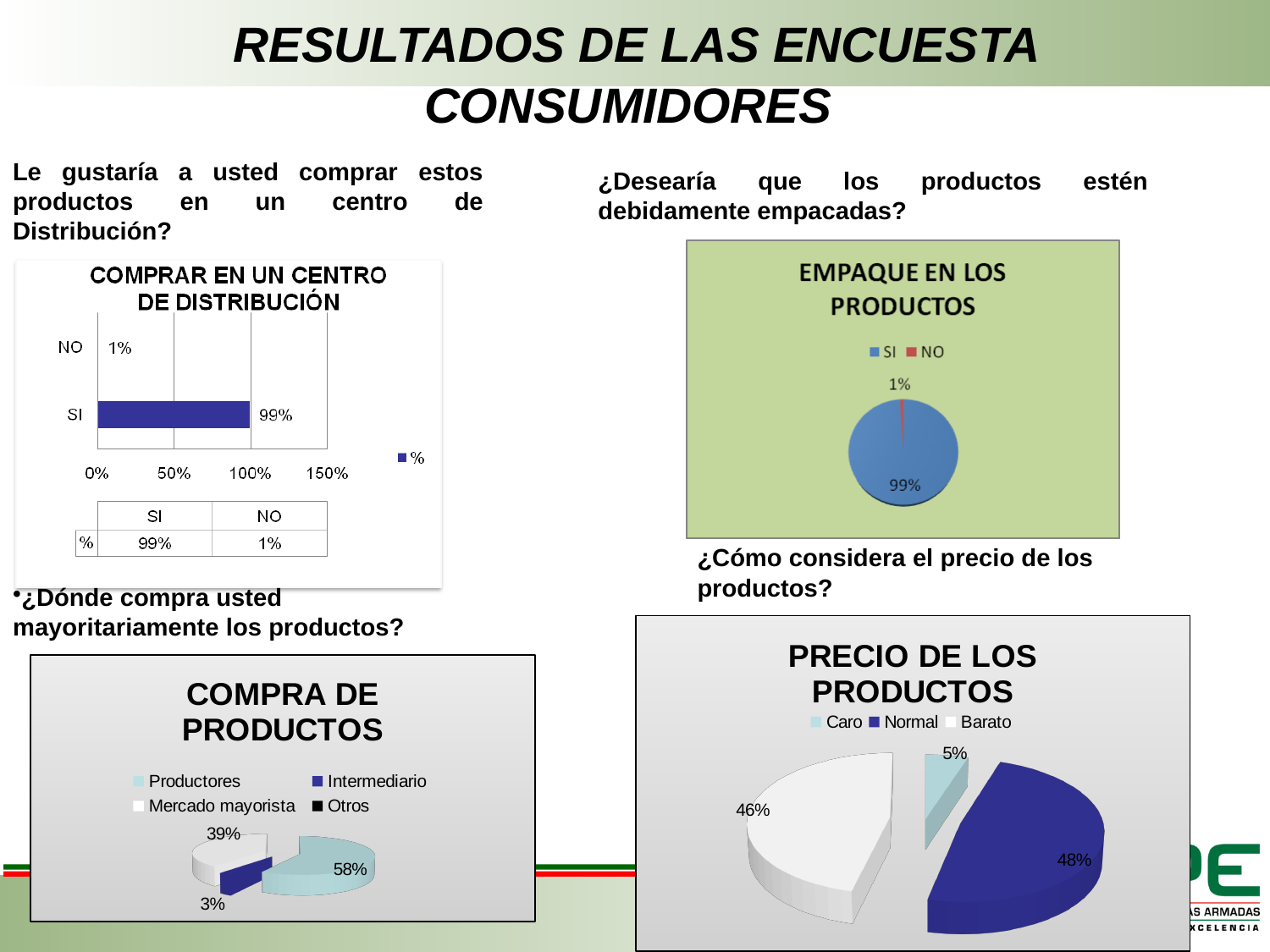
What kind of chart is 'COMPRAR EN UN CENTRO DE DISTRIBUCIÓN'? Bar chart In the 'EMPAQUE EN LOS PRODUCTOS' pie chart, which category is the smallest? NO In the 'PRECIO DE LOS PRODUCTOS' pie chart, what is the difference between the Normal and Barato values? 2% In the 'COMPRA DE PRODUCTOS' pie chart, what share does Productores have? 58% In the 'COMPRAR EN UN CENTRO DE DISTRIBUCIÓN' chart, what is the value for NO? 1% How many entries does the legend of the 'COMPRA DE PRODUCTOS' chart list? 4 In the 'EMPAQUE EN LOS PRODUCTOS' pie chart, what share does SI have? 99% In the 'COMPRAR EN UN CENTRO DE DISTRIBUCIÓN' chart, what is the value for SI? 99% In the 'COMPRAR EN UN CENTRO DE DISTRIBUCIÓN' chart, what is the difference between the SI and NO values? 98% In the 'COMPRA DE PRODUCTOS' pie chart, what is the value for Mercado mayorista? 39% In the 'PRECIO DE LOS PRODUCTOS' pie chart, what is the value for Caro? 5% In the 'PRECIO DE LOS PRODUCTOS' pie chart, which category is the largest? Normal